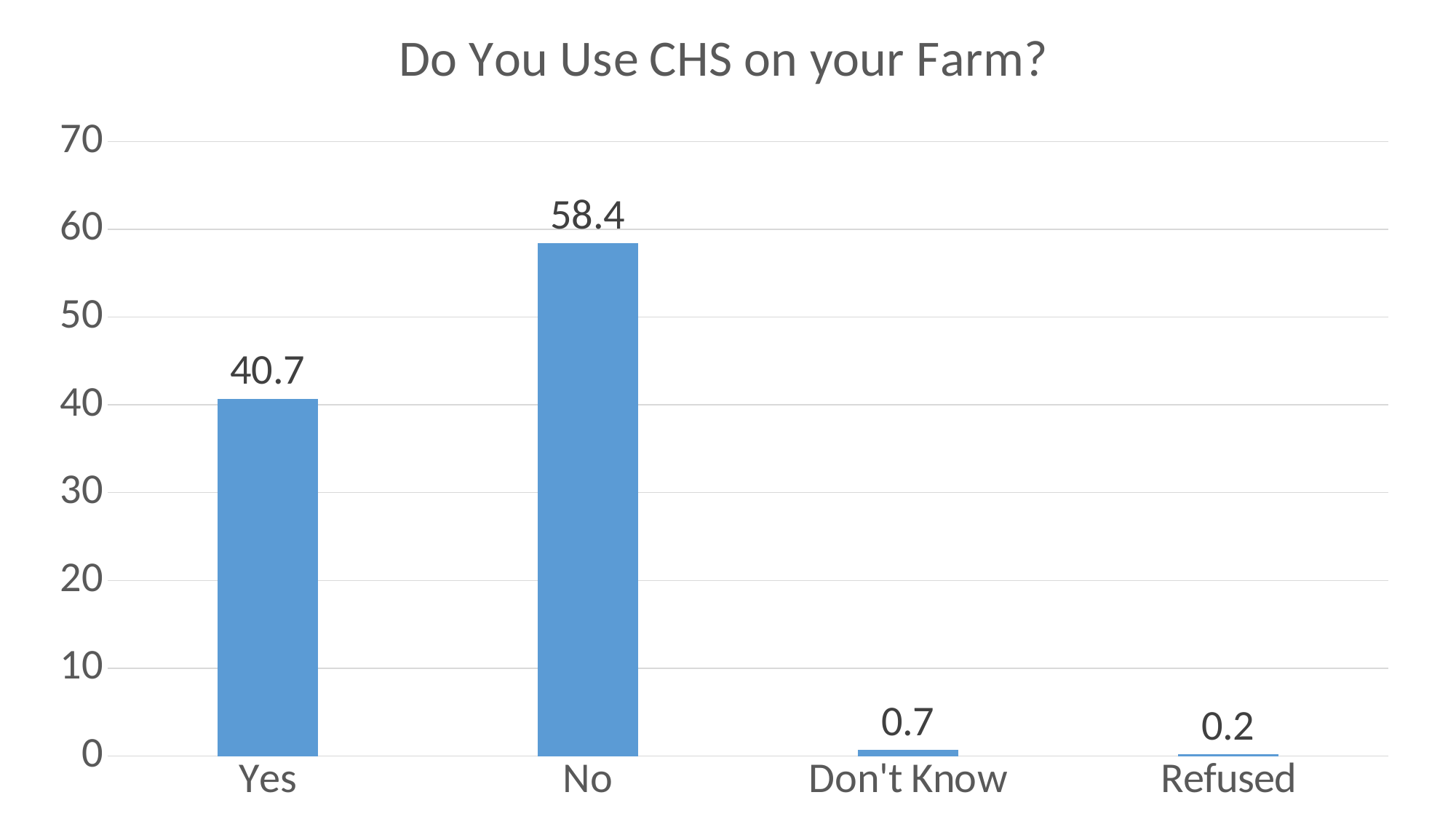
How many categories are shown on the x axis? 4 Which is larger, the value for Yes or the value for No? No What is the value for Don't Know? 0.7 What kind of chart is this? bar chart Which category has the highest value? No What is the title of the chart? Do You Use CHS on your Farm? What is the difference between the values for No and Yes? 17.7 Is the value for Yes greater or less than 50? less What is the value for Yes? 40.7 What is the value for No? 58.4 Which category has the lowest value? Refused What is the value for Refused? 0.2